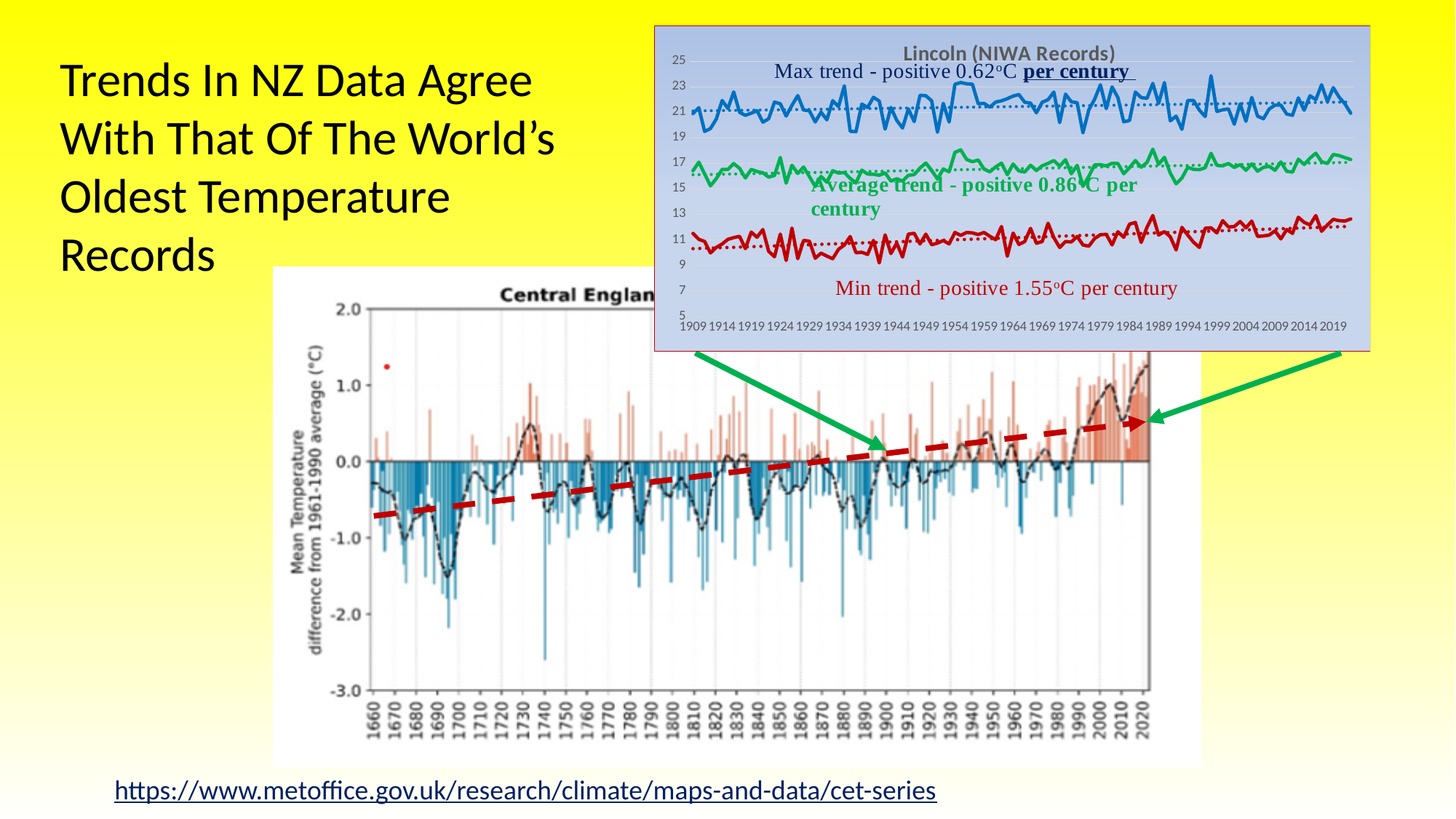
What is the y-axis label on the Central England chart? Mean Temperature difference from 1961-1990 average (°C) On the Lincoln (NIWA Records) chart, how much larger is the Min trend than the Max trend per century? 0.93°C per century On the Lincoln (NIWA Records) chart, which series has the largest trend per century? Min On the Lincoln (NIWA Records) chart, what is the stated Average trend per century? positive 0.86°C per century How many temperature series are plotted on the Lincoln (NIWA Records) chart? 3 What kind of chart is the Lincoln (NIWA Records) chart? line chart On the Lincoln (NIWA Records) chart, what is the stated Min trend per century? positive 1.55°C per century On the Central England chart, does the dashed smoothed line generally rise or fall from 1660 to 2020? rise What kind of chart is the Central England chart at the bottom of the slide? bar chart On the Lincoln (NIWA Records) chart, what is the stated Max trend per century? positive 0.62°C per century On the Lincoln (NIWA Records) chart, which series has the smallest trend per century? Max